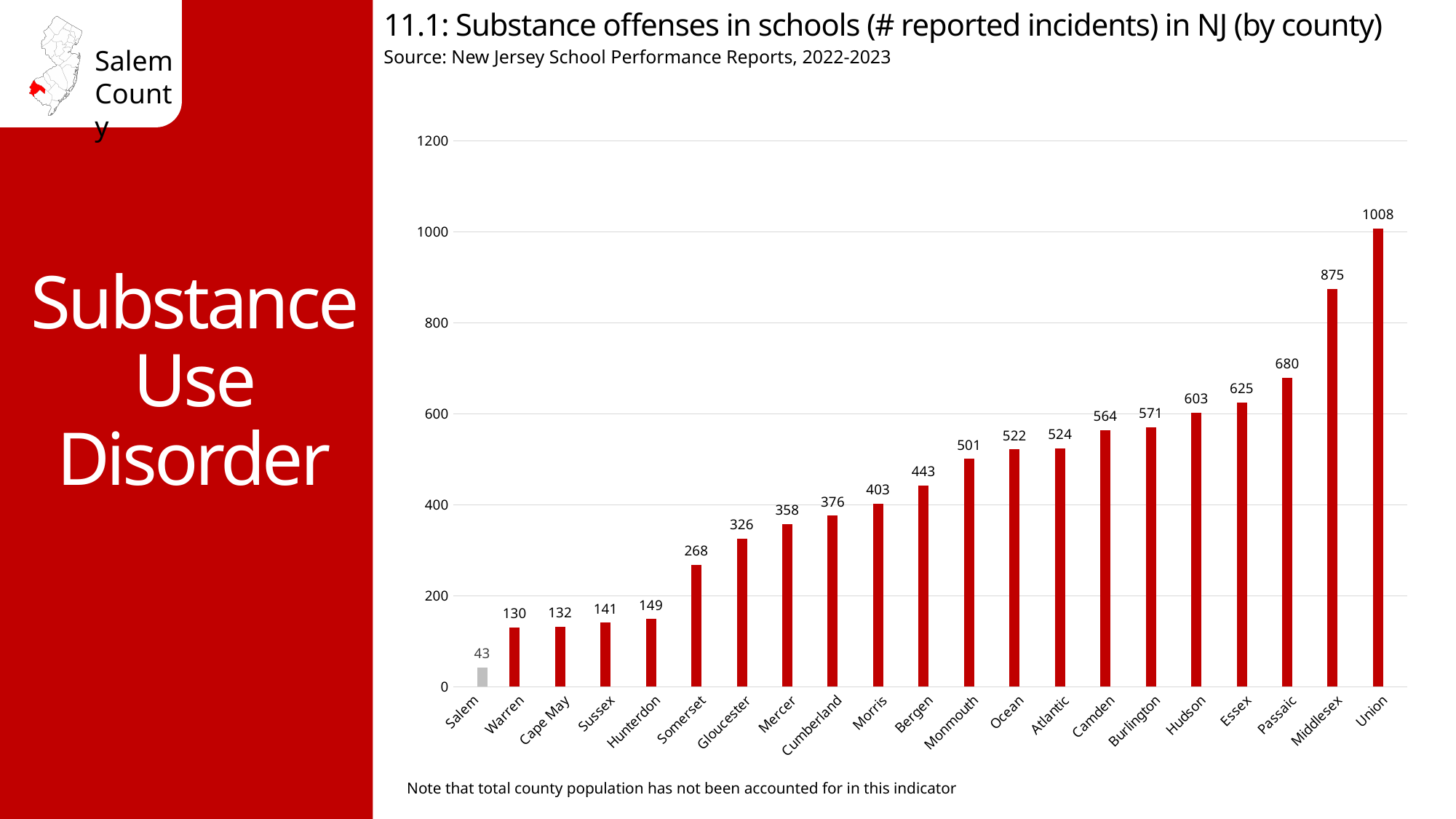
Is the value for Passaic greater or less than 600? greater What is the difference between the values for Union and Middlesex? 133 Do the values rise or fall moving from left to right along the x axis? Rise What kind of chart is shown on the slide? Bar chart How many counties are shown on the x axis? 21 What is the number of reported substance offense incidents in schools for Salem county? 43 Which county has a larger value, Camden or Bergen? Camden What is the value shown for Middlesex county? 875 Which county has the lowest number of reported incidents? Salem Which county has the highest number of reported incidents? Union Which bar is coloured differently (grey) from the rest? Salem What is the value shown for Monmouth county? 501